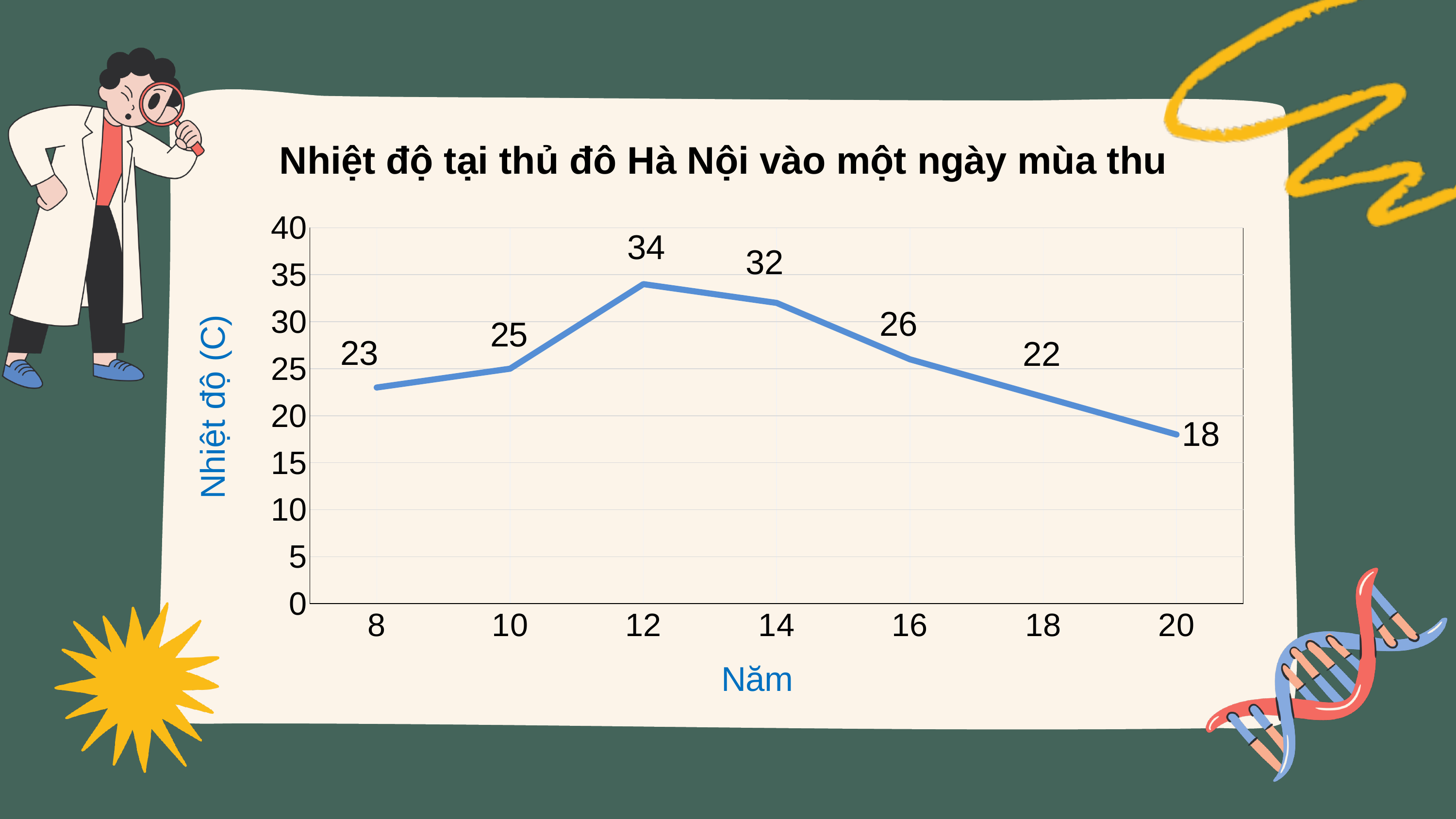
What is the value at x = 20? 18 What is the value at x = 8? 23 At which x value is the temperature lowest? 20 What is the difference between the values at x = 12 and x = 20? 16 How many data points are plotted on the line? 7 What is the title of the chart? Nhiệt độ tại thủ đô Hà Nội vào một ngày mùa thu What is the value at x = 12? 34 What kind of chart is shown on the slide? line chart At which x value is the temperature highest? 12 Which is larger, the value at x = 10 or the value at x = 16? x = 16 Is the value at x = 14 greater or less than 30? greater Do the values rise or fall from x = 12 to x = 20? fall